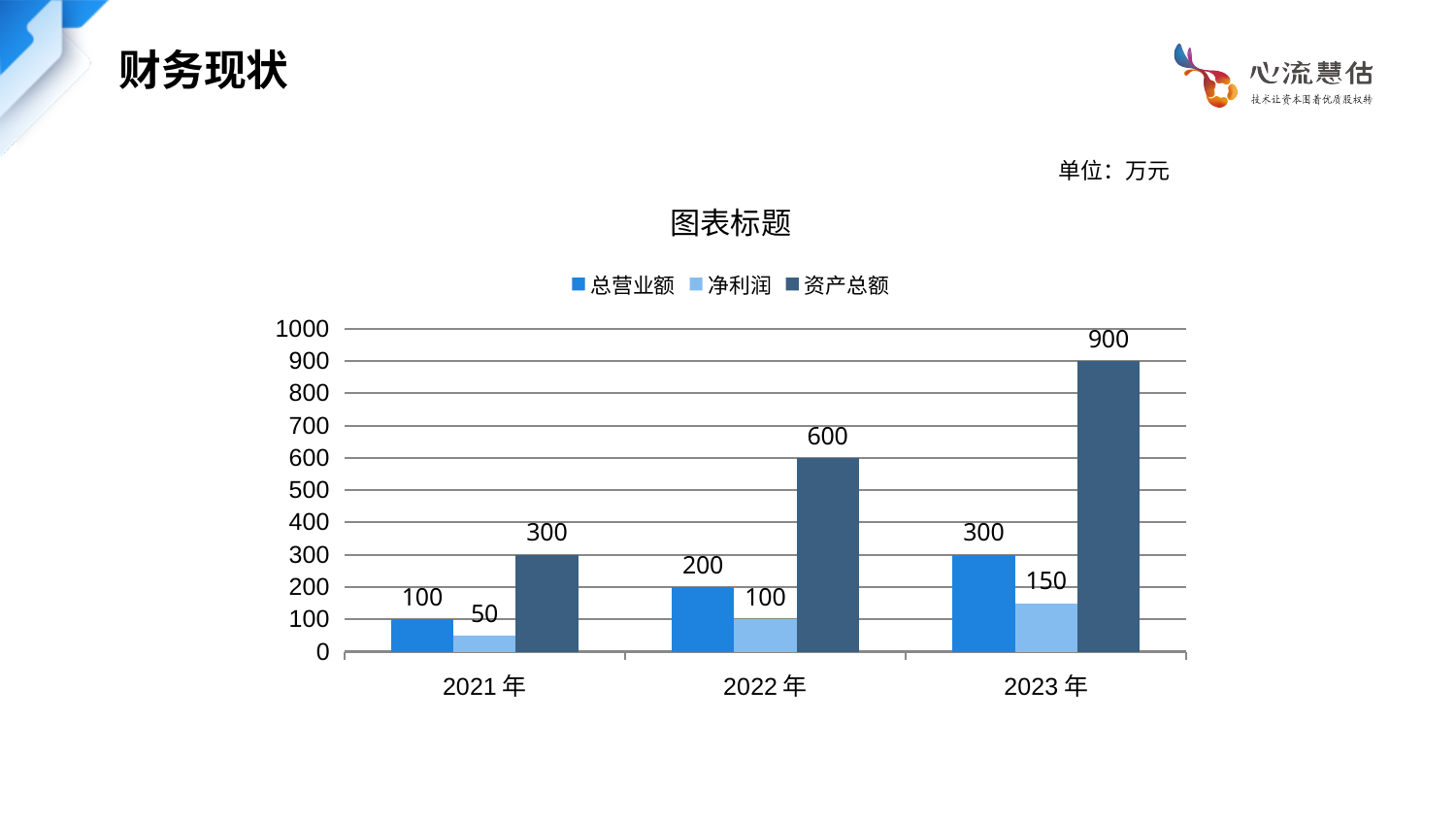
Which year has the lowest 净利润? 2021 年 Which year has the highest 资产总额? 2023 年 What is the value of 资产总额 for 2023 年? 900 Which is larger: 总营业额 in 2022 年 or 净利润 in 2023 年? 总营业额 in 2022 年 How many years are shown on the x axis? 3 What is the difference between 资产总额 in 2023 年 and 2022 年? 300 What is the value of 净利润 for 2023 年? 150 What is the value of 总营业额 for 2021 年? 100 How many series does the legend list? 3 What is the value of 净利润 for 2022 年? 100 Does 总营业额 rise or fall from 2021 年 to 2023 年? Rise What kind of chart is shown? Bar chart